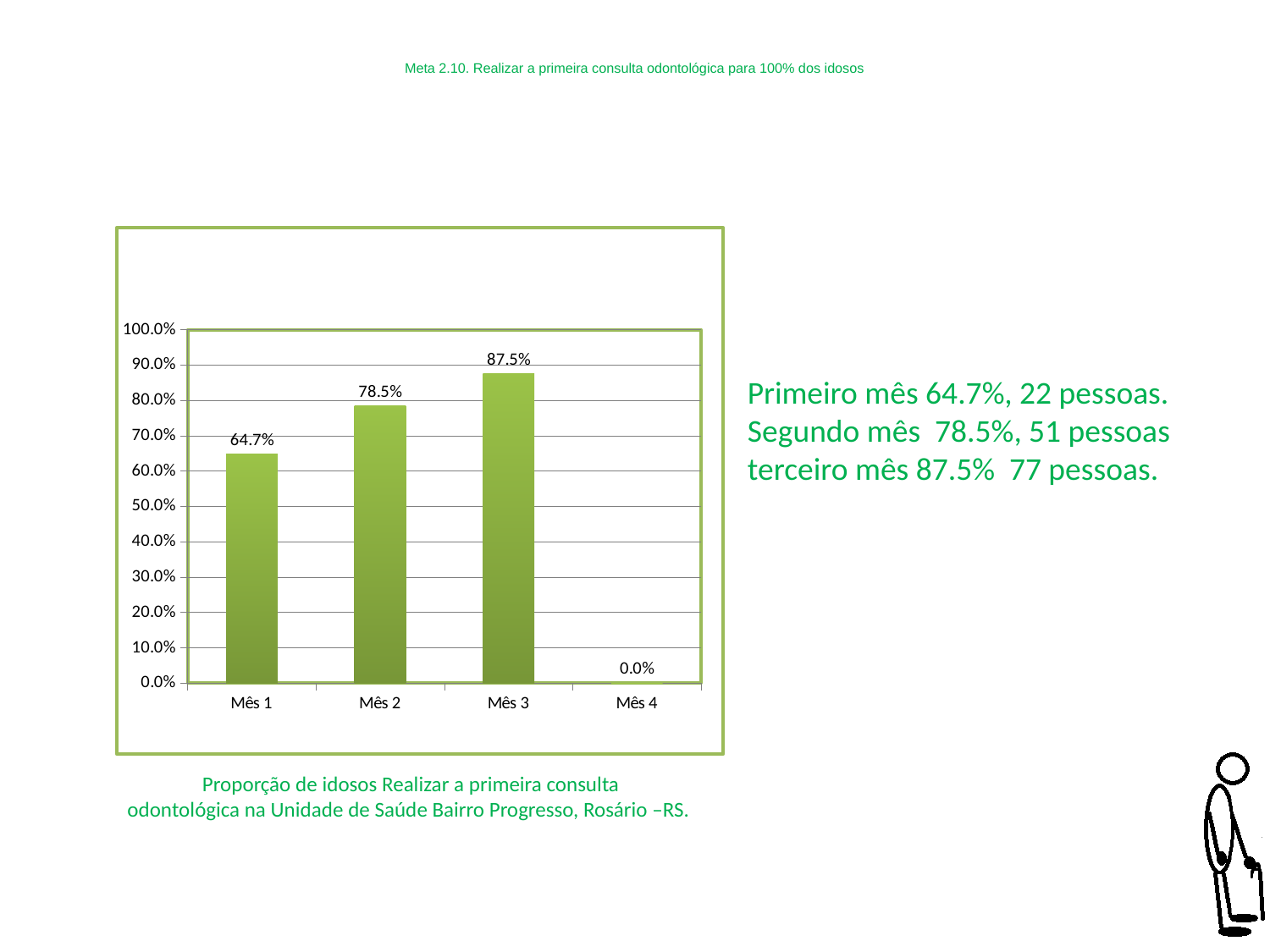
How many months are shown on the x axis? 4 What is the value for Mês 2? 78.5% What is the difference between the values for Mês 3 and Mês 1? 22.8% What is the value for Mês 4? 0.0% What is the value for Mês 3? 87.5% Which month has the lowest value? Mês 4 Is the value for Mês 2 greater or less than 70.0%? greater Which month has the highest value? Mês 3 Which is larger, the value for Mês 2 or the value for Mês 1? Mês 2 What kind of chart is shown on the slide? bar chart What is the value for Mês 1? 64.7% Do the values rise or fall from Mês 1 to Mês 3? rise